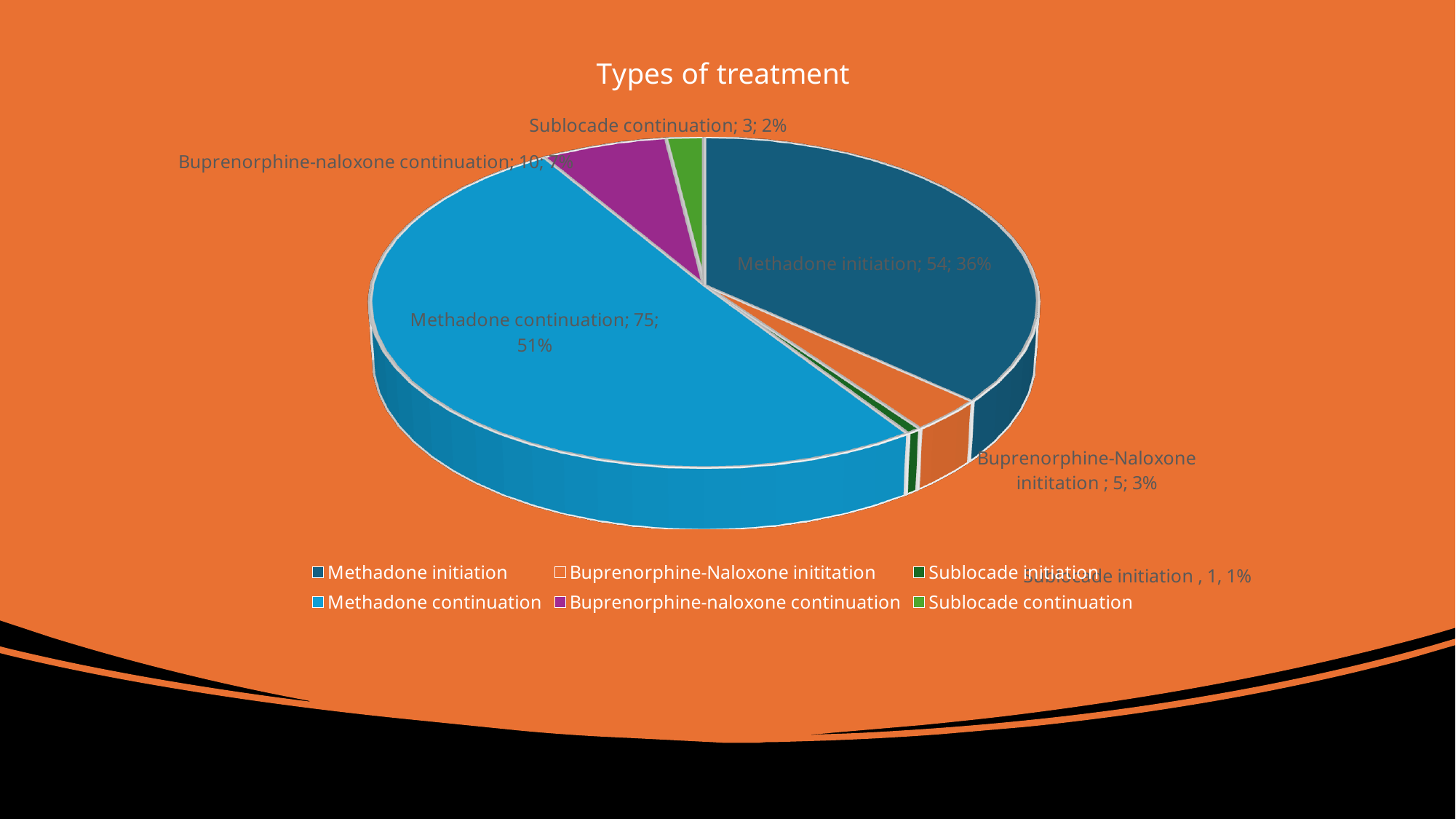
What kind of chart is shown on the slide? Pie chart Which category has the largest slice? Methadone continuation What is the difference in cases between Methadone continuation and Methadone initiation? 21 How many categories does the legend list? 6 Which category has the smallest slice? Sublocade initiation What percentage of the pie is Sublocade continuation? 2% What colour is the Methadone continuation slice? Light blue How many cases are shown for Methadone continuation? 75 What percentage of the pie is Methadone initiation? 36% How many cases are shown for Buprenorphine-Naloxone initiation? 5 Which is larger, Buprenorphine-naloxone continuation or Sublocade continuation? Buprenorphine-naloxone continuation What is the title of the chart? Types of treatment